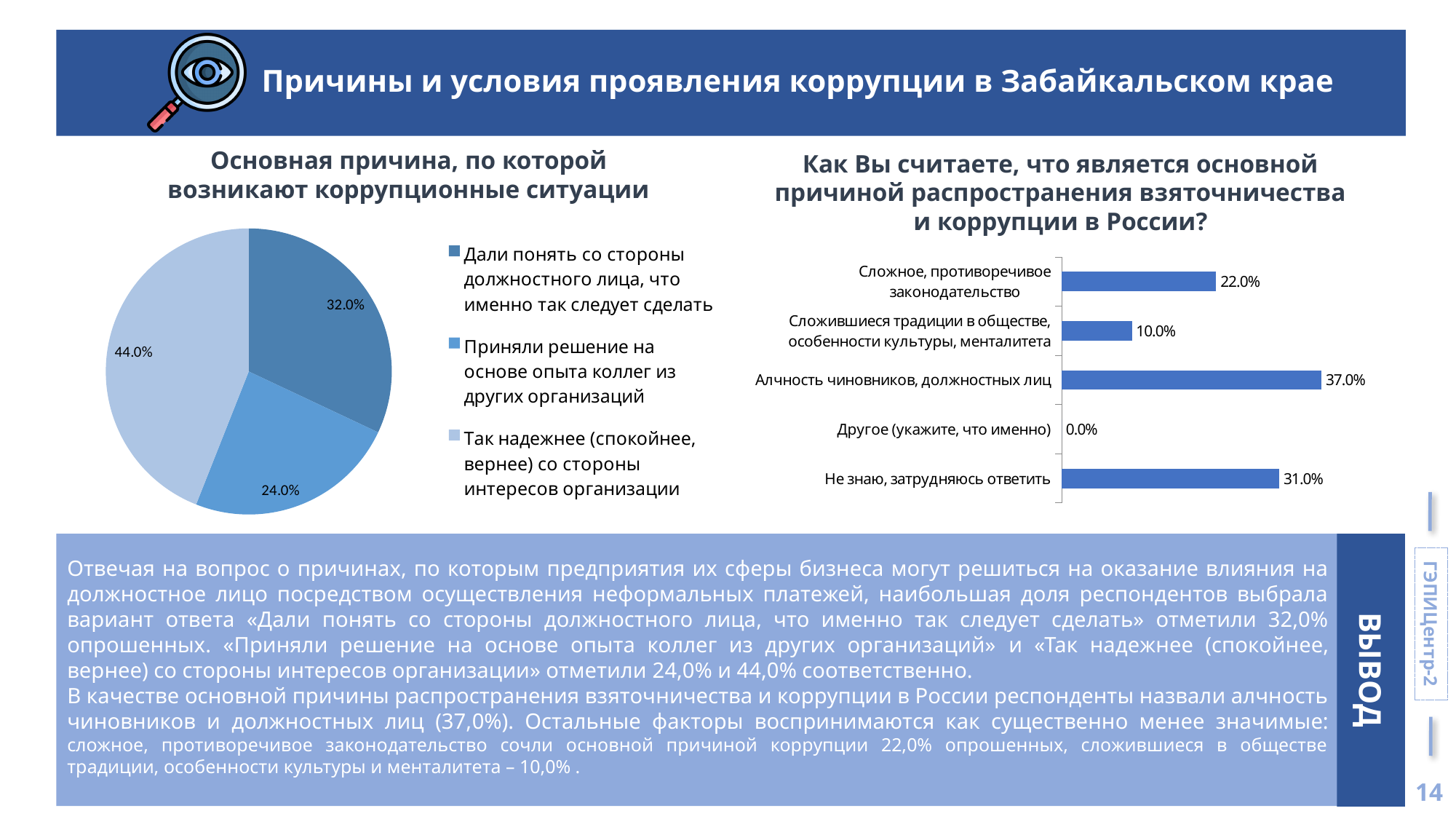
What type of chart is shown on the right side of the slide, under the title 'Как Вы считаете, что является основной причиной распространения взяточничества и коррупции в России?'? Bar chart In the pie chart on the left, how many slices are there? 3 In the pie chart on the left, what share is shown for 'Дали понять со стороны должностного лица, что именно так следует сделать'? 32.0% In the pie chart on the left, what is the difference between the shares for 'Так надежнее (спокойнее, вернее) со стороны интересов организации' and 'Приняли решение на основе опыта коллег из других организаций'? 20.0% In the bar chart on the right, which is larger: 'Сложное, противоречивое законодательство' or 'Не знаю, затрудняюсь ответить'? Не знаю, затрудняюсь ответить In the bar chart on the right, which category has the lowest value? Другое (укажите, что именно) In the pie chart on the left, which category has the smallest slice? Приняли решение на основе опыта коллег из других организаций In the bar chart on the right, what is the value for 'Алчность чиновников, должностных лиц'? 37.0% In the bar chart on the right, what is the value for 'Сложившиеся традиции в обществе, особенности культуры, менталитета'? 10.0% In the bar chart on the right, how many categories are shown? 5 In the pie chart on the left, which category has the largest slice? Так надежнее (спокойнее, вернее) со стороны интересов организации In the pie chart 'Основная причина, по которой возникают коррупционные ситуации', what share is shown for 'Так надежнее (спокойнее, вернее) со стороны интересов организации'? 44.0%